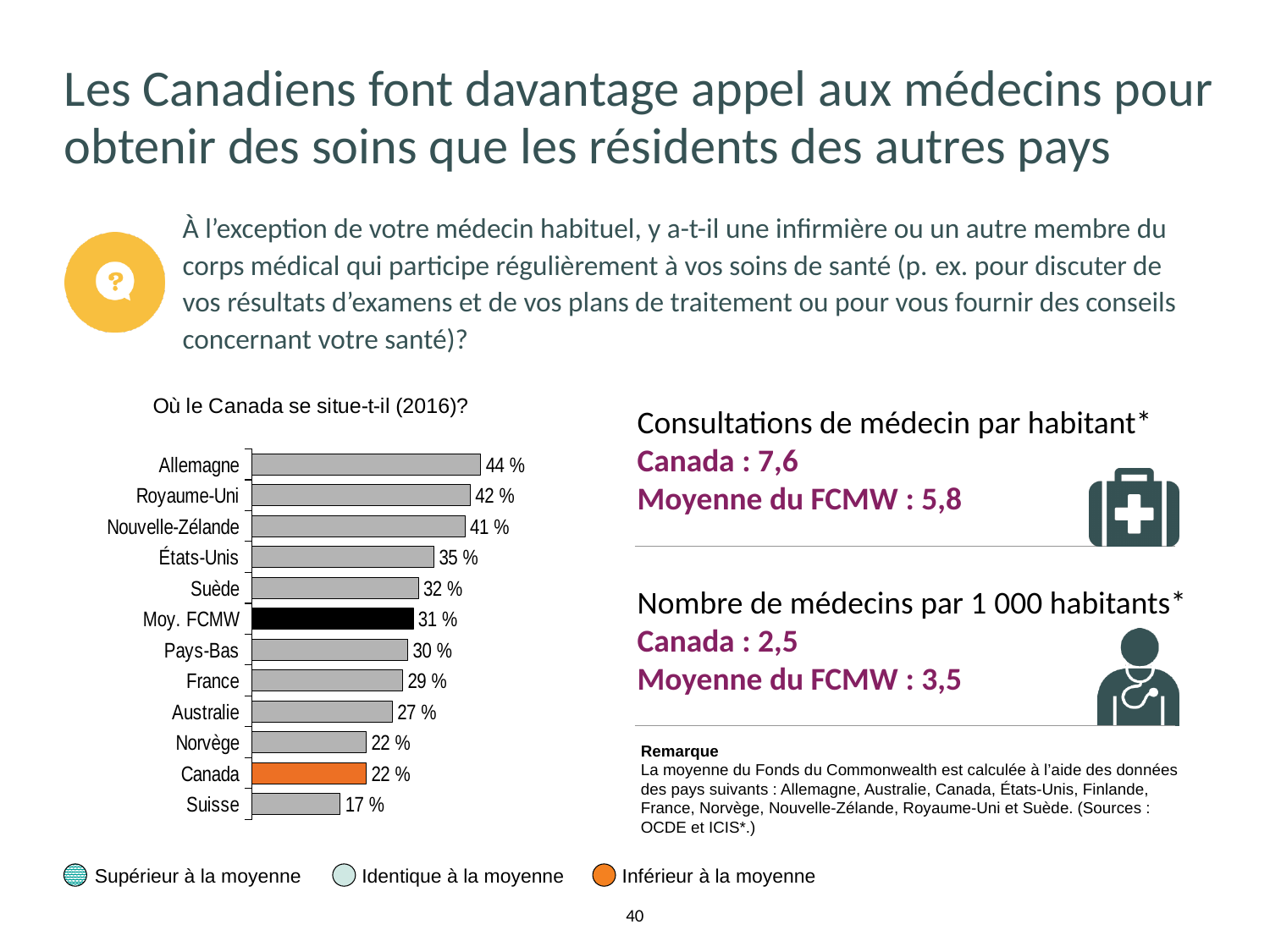
What type of chart is shown on the slide? Bar chart What is the value for Nouvelle-Zélande in the chart? 41 % What is the title of the chart on the slide? Où le Canada se situe-t-il (2016)? Which country has the lowest value in the chart? Suisse Which country has the highest value in the chart? Allemagne What is the difference between the values for Allemagne and Canada? 22 % Which has a larger value, États-Unis or Suède? États-Unis How many categories are shown in the bar chart? 12 What is the value for Allemagne in the chart? 44 % What is the difference between the values for Moy. FCMW and Canada? 9 % What is the value for Moy. FCMW in the chart? 31 % What is the value for Canada in the chart? 22 %